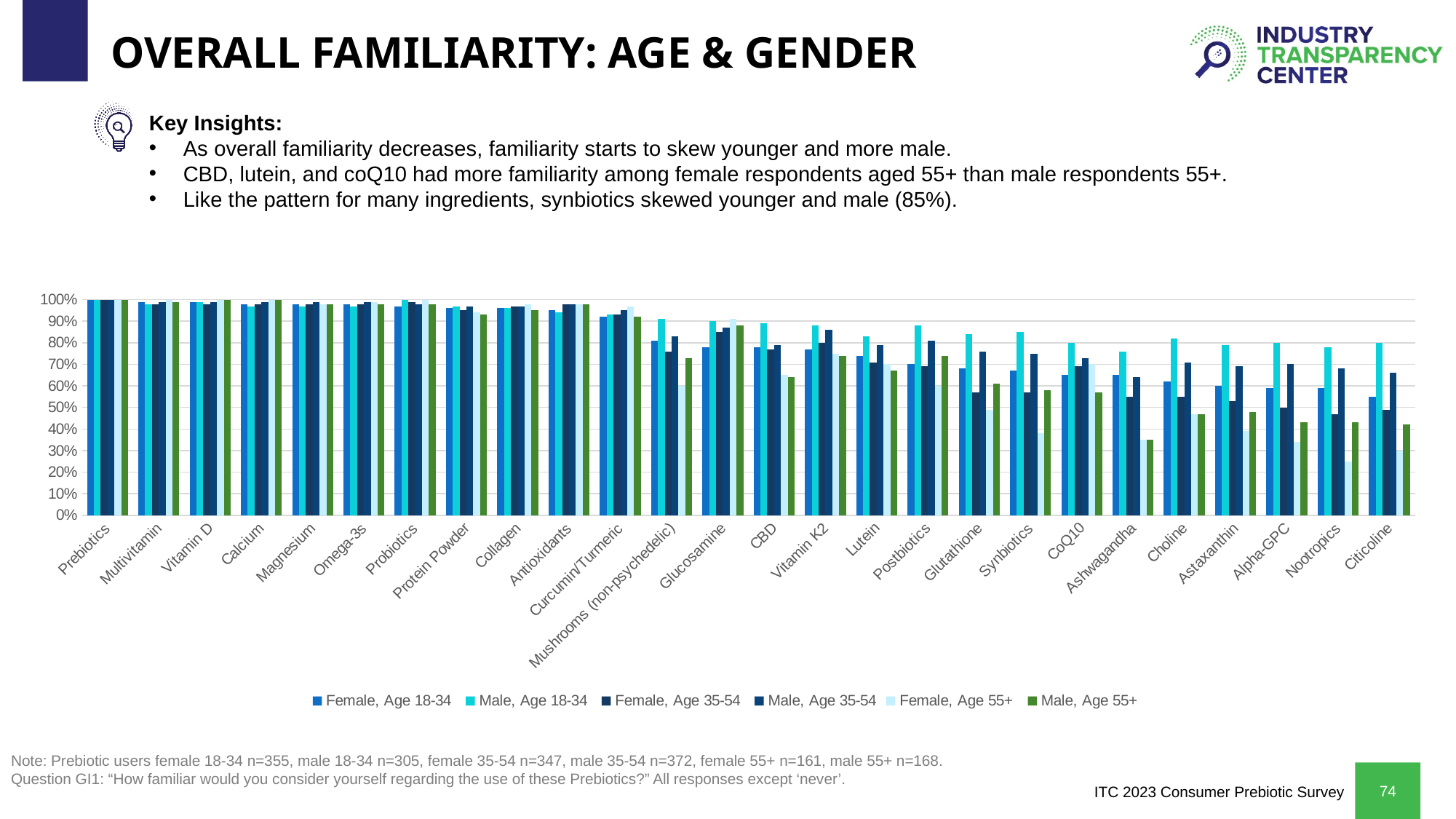
Which ingredient category appears first (leftmost) on the x axis? Prebiotics How many series does the chart legend list? 6 Is the Male, Age 55+ value for Ashwagandha greater or less than 40%? less Is the Female, Age 55+ value for Nootropics greater or less than 30%? less For Synbiotics, which is larger: the Male, Age 18-34 value or the Female, Age 18-34 value? Male, Age 18-34 Do the familiarity values generally rise or fall moving from left to right along the x axis? fall Is the Male, Age 18-34 value for Postbiotics greater or less than 80%? greater Which series in the legend is shown in green? Male, Age 55+ What type of chart is shown on the slide? bar chart How many ingredient categories are shown on the x axis of the chart? 26 Which ingredient category has the lowest Female, Age 55+ value? Nootropics